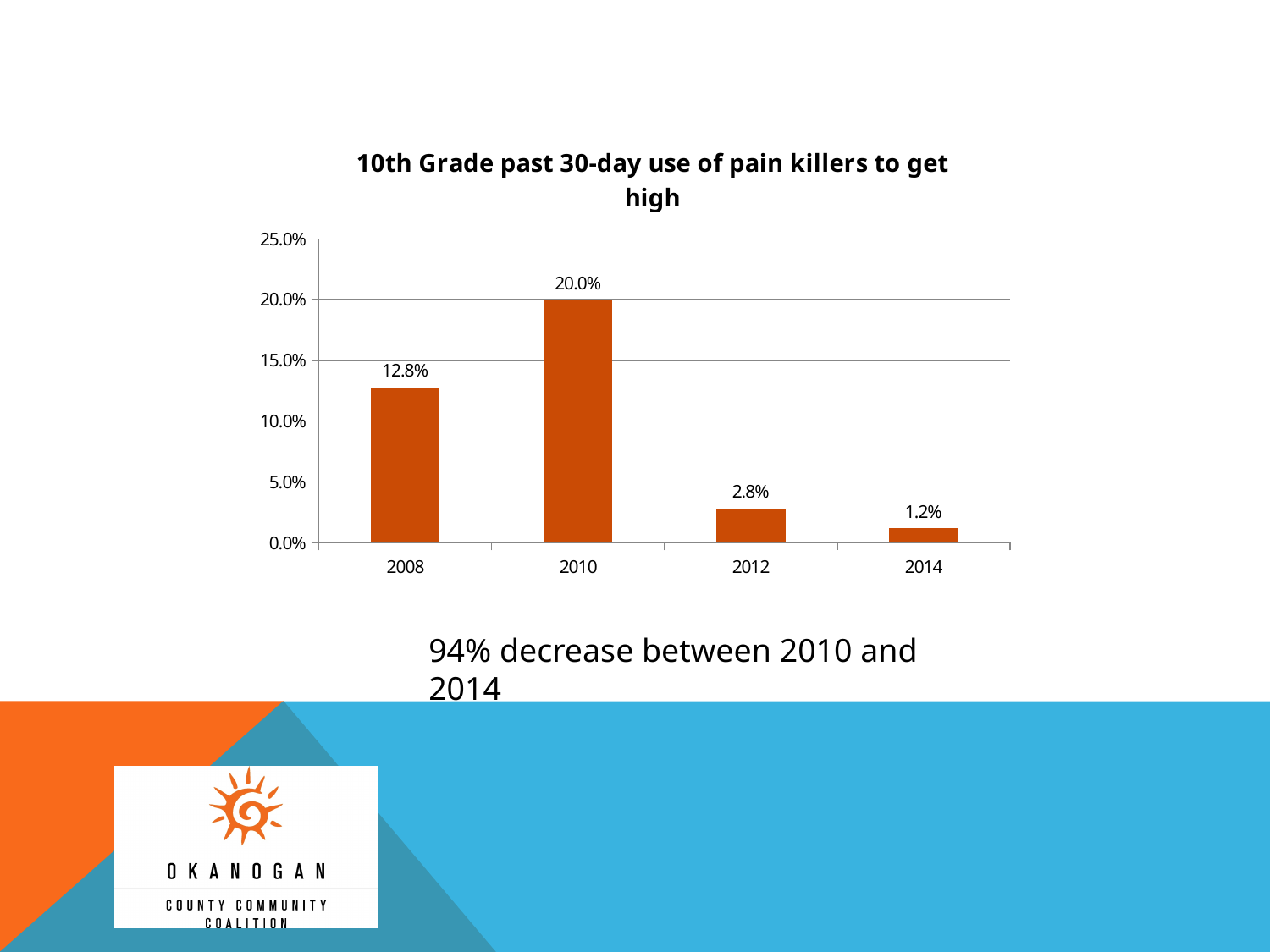
What is the value for 2008? 12.8% What is the title of the chart? 10th Grade past 30-day use of pain killers to get high What is the difference between the values for 2012 and 2014? 1.6% Which is larger, the value for 2008 or the value for 2012? 2008 What is the value for 2010? 20.0% What kind of chart is shown on the slide? Bar chart What is the value for 2014? 1.2% Which year has the lowest value? 2014 What is the difference between the values for 2010 and 2008? 7.2% What is the value for 2012? 2.8% Which year has the highest value? 2010 How many years are shown on the x axis? 4